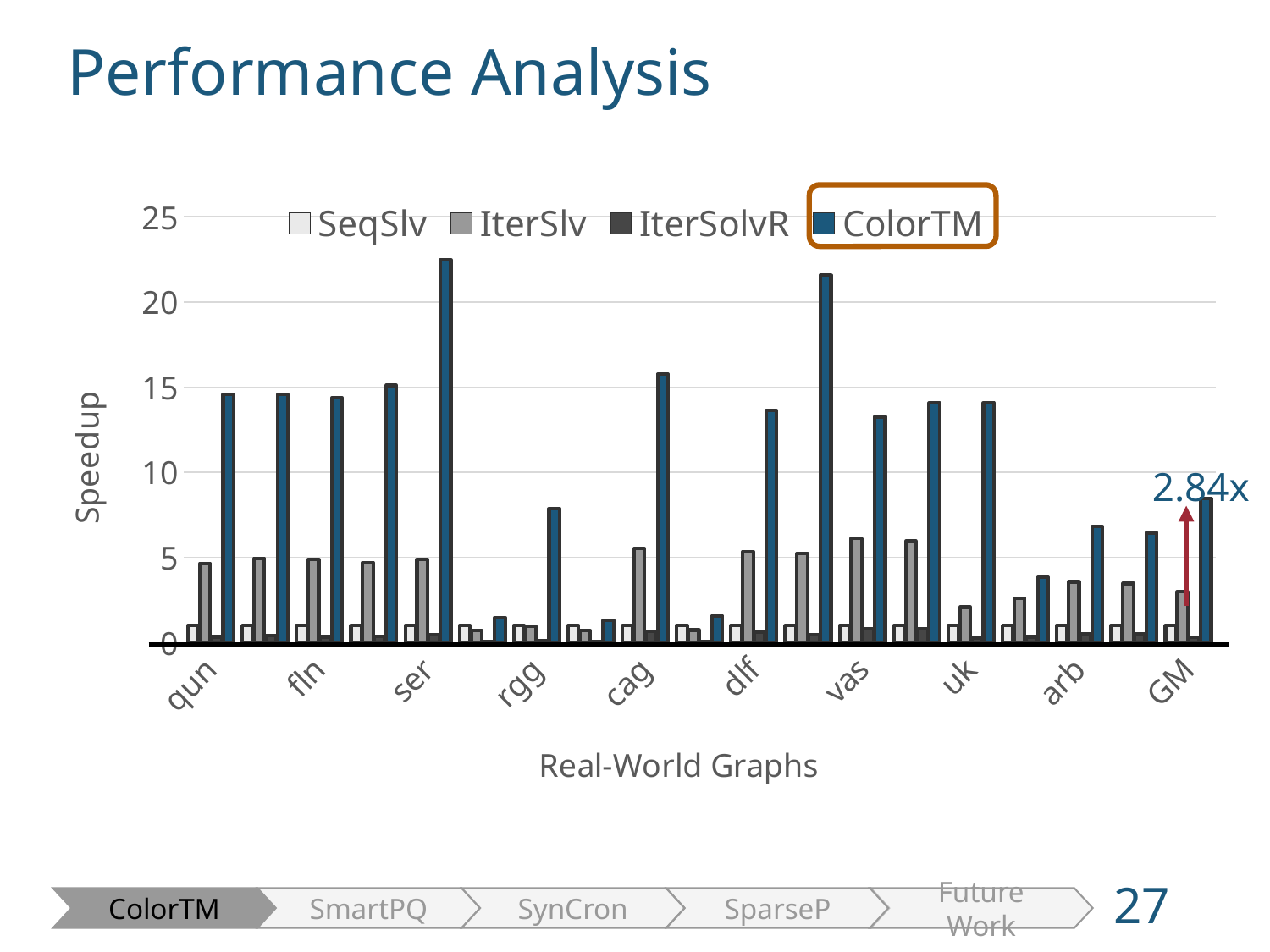
How many series does the legend list? 4 How many graph names are labeled on the x axis? 10 Which is larger for qun, the IterSlv bar or the ColorTM bar? ColorTM What is the label of the y axis? Speedup What value is annotated above the GM group on the chart? 2.84x Is the ColorTM value for rgg greater or less than 10? less What kind of chart is shown on the slide? bar chart Which series is highlighted with an orange box in the legend? ColorTM Which series has the tallest bar in the ser group? ColorTM Is the ColorTM value for ser greater or less than 20? greater Is the ColorTM value for GM greater or less than 5? greater